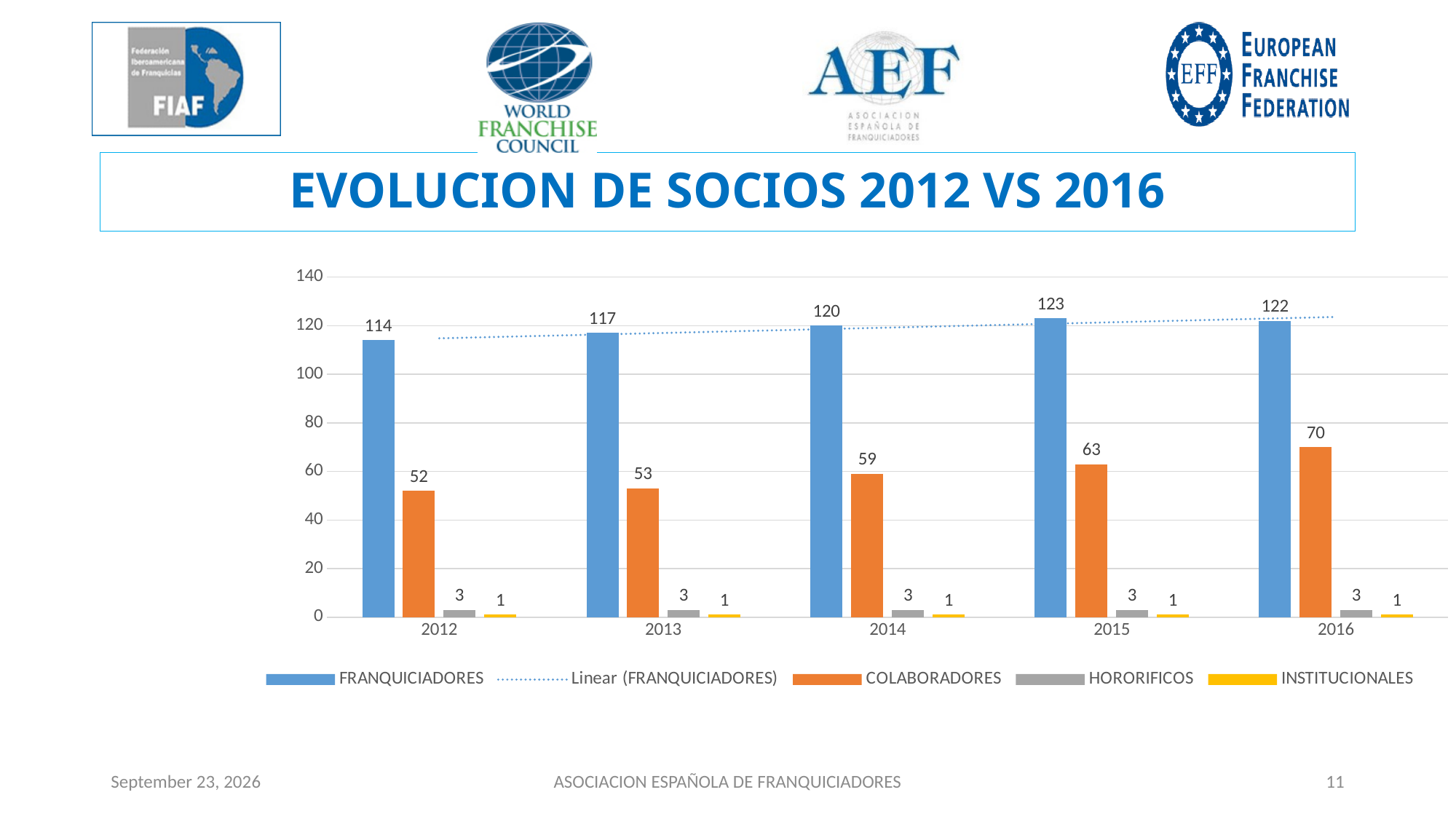
What kind of chart is shown on the slide? Bar chart Do the COLABORADORES values rise or fall from 2012 to 2016? Rise What is the value for COLABORADORES in 2016? 70 What is the difference between the COLABORADORES values in 2016 and 2012? 18 Which is larger, FRANQUICIADORES in 2016 or FRANQUICIADORES in 2015? FRANQUICIADORES in 2015 In which year is the FRANQUICIADORES value highest? 2015 How many entries does the legend list? 5 In which year is the COLABORADORES value lowest? 2012 What is the value for HORORIFICOS in 2014? 3 How many years are shown on the x axis? 5 What is the difference between the FRANQUICIADORES values in 2015 and 2012? 9 What is the value for FRANQUICIADORES in 2012? 114